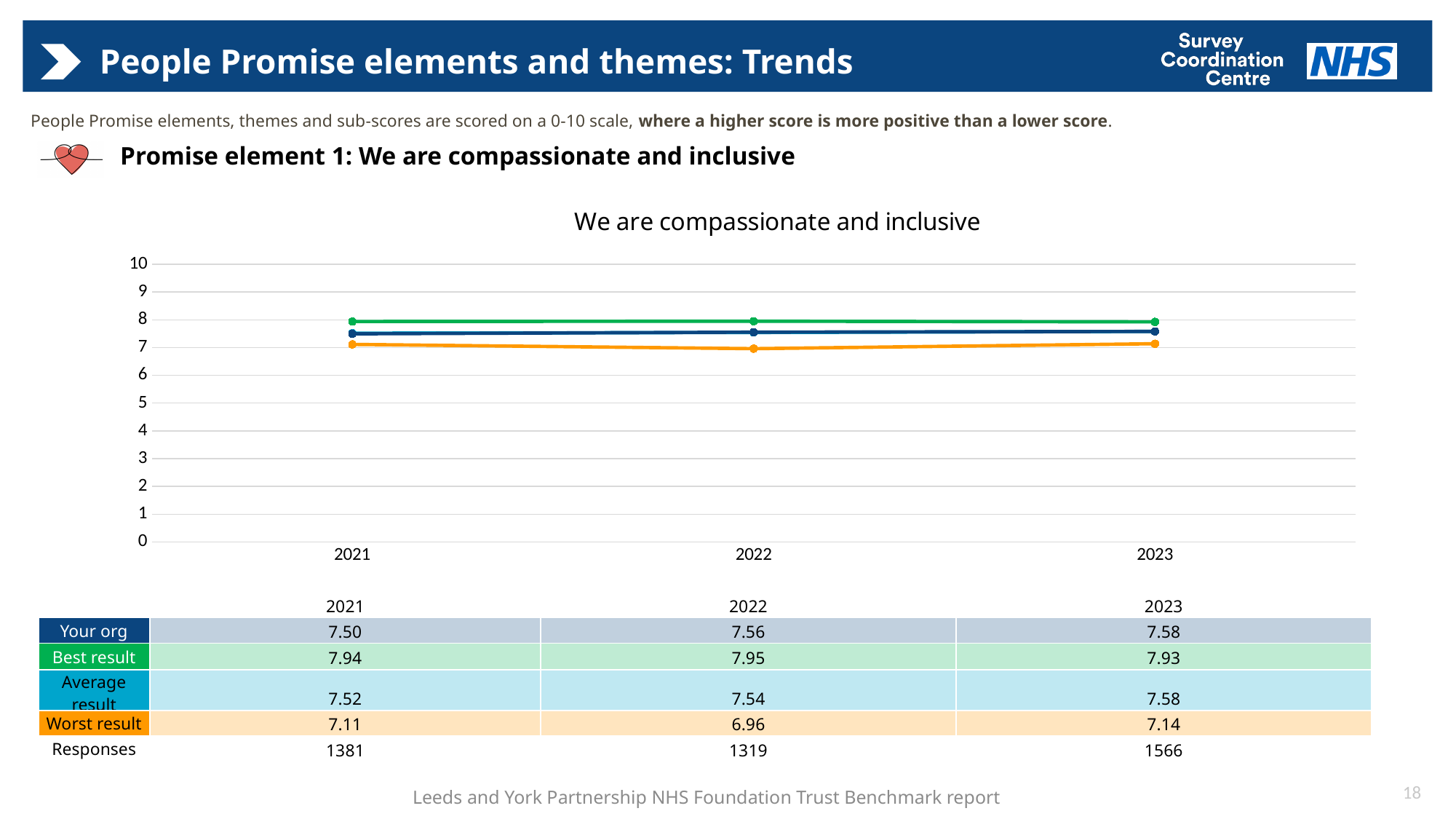
What was the 'Average result' score in 2022? 7.54 What was the 'Worst result' score in 2023? 7.14 Does the 'Your org' score rise or fall from 2021 to 2023? rise What type of chart is shown under the title 'We are compassionate and inclusive'? line chart What was the 'Your org' score in 2021? 7.50 What is the difference between the 'Best result' and 'Your org' scores in 2021? 0.44 How many years are shown on the x axis of the chart? 3 Is the 'Worst result' value for 2022 greater or less than 7? less In which year was the 'Your org' score highest? 2023 In which year was the 'Worst result' score lowest? 2022 Which is larger in 2023: the 'Best result' score or the 'Worst result' score? Best result What was the 'Best result' score in 2022? 7.95